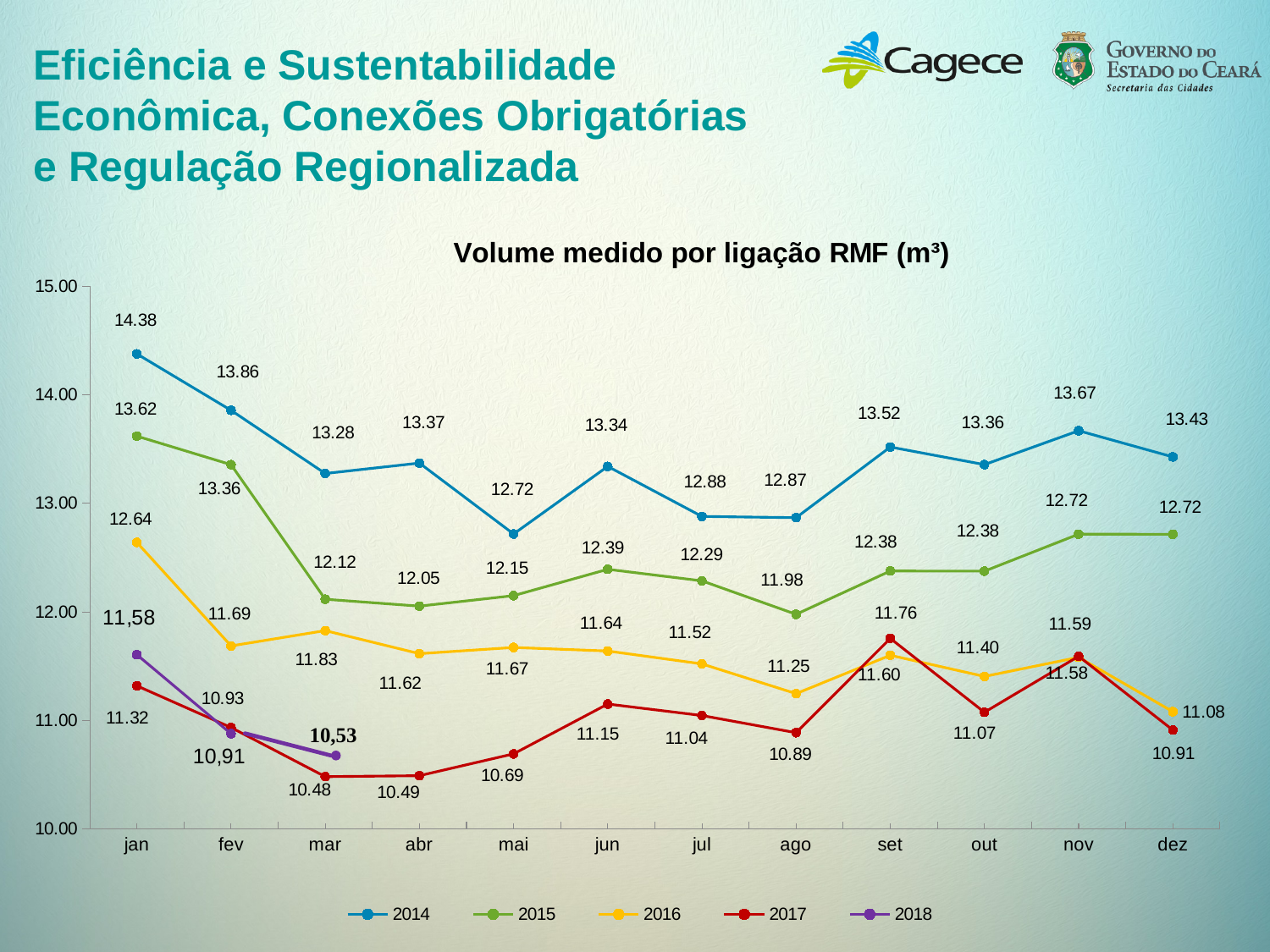
In which month does the 2016 series reach its lowest value? dez Is the value for 2017 in abr greater or less than 11.00? less In which month does the 2014 series reach its highest value? jan Which is larger in set: the 2017 value or the 2016 value? 2017 What kind of chart is shown on the slide? line chart How many months are shown on the x axis? 12 What is the difference between the 2014 and 2015 values in jan? 0.76 How many series does the legend list? 5 What is the value for 2018 in mar? 10,53 Does the 2014 series rise or fall from jan to mar? fall What is the value for 2014 in jan? 14.38 What is the value for 2017 in set? 11.76